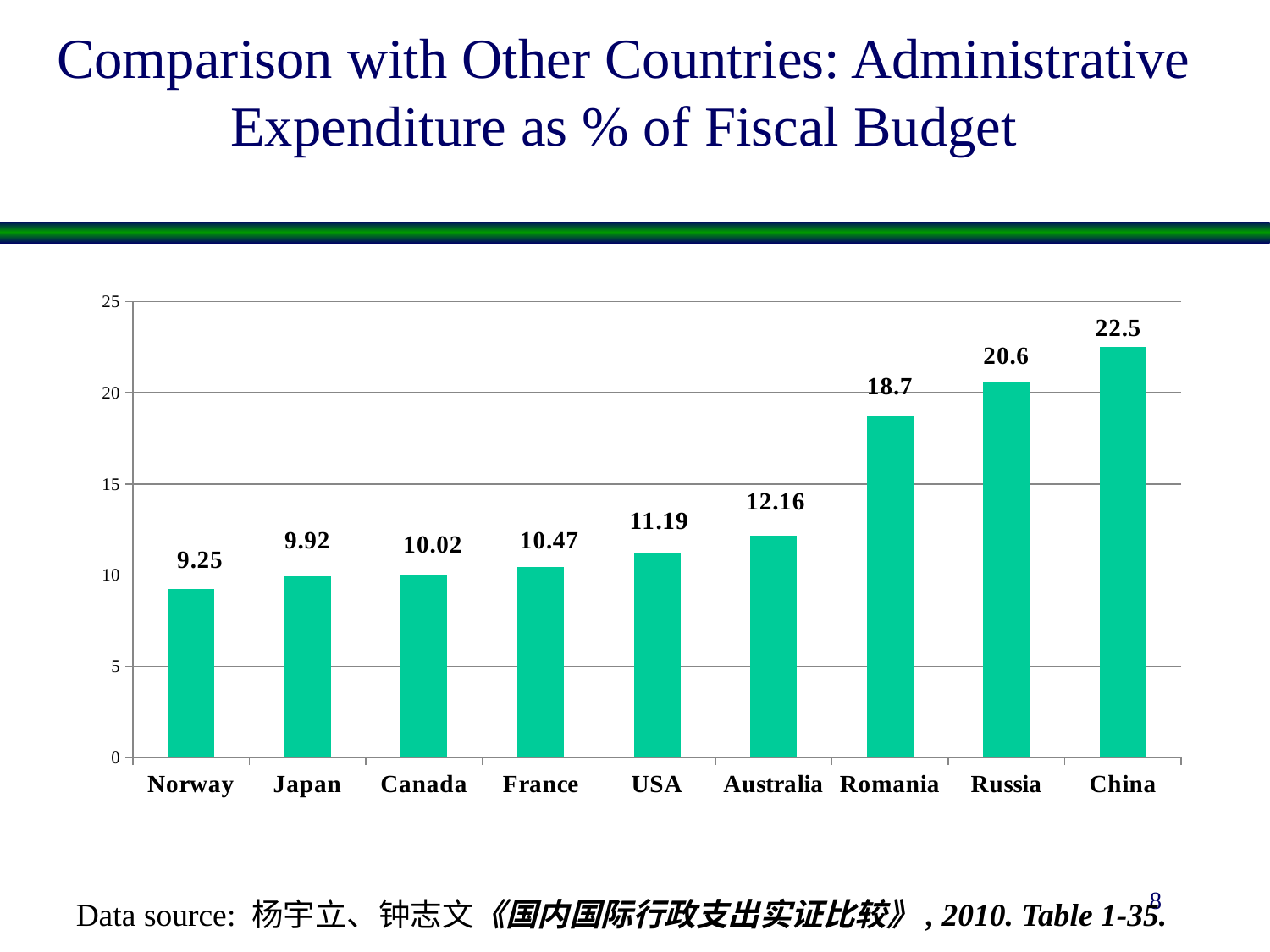
What is the difference between the values for Russia and Romania? 1.9 Is the value for Romania greater or less than 15? greater Do the values rise or fall from left to right along the x axis? rise What is the value for China? 22.5 What is the difference between the values for China and Norway? 13.25 What is the value for Norway? 9.25 Which is larger, the value for USA or the value for France? USA How many countries are shown in the chart? 9 What kind of chart is shown on the slide? bar chart Which country has the lowest value? Norway What is the value for Australia? 12.16 Which country has the highest value? China